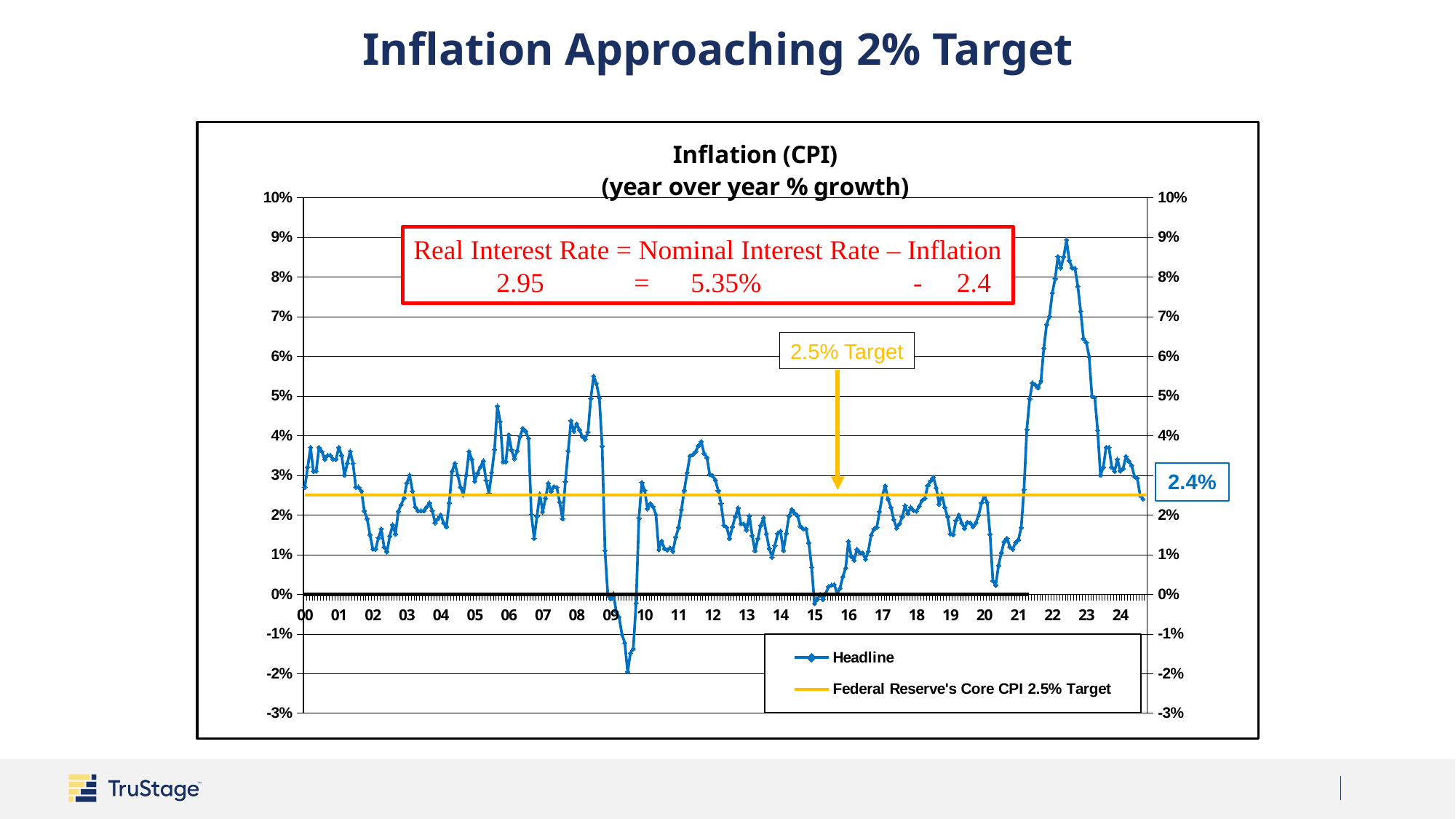
Is the latest Headline value (2.4%) above or below the 2.5% target line? below Is the lowest point of the Headline series around 2009 greater or less than -1%? less Which is higher: the Headline peak around 2008 or the Headline peak around 2022? 2022 What is the most recent Headline inflation value labeled on the chart? 2.4% At what level is the Federal Reserve's Core CPI target line drawn? 2.5% Is the peak of the Headline series around 2022 greater or less than 8%? greater What kind of chart is shown on the slide? line chart In which year label does the Headline series reach its lowest value? 09 How many series does the legend list? 2 From the 2022 peak to the end of 2024, do Headline values rise or fall? fall What is the title of the chart? Inflation (CPI) (year over year % growth) In which year label does the Headline series reach its highest value? 22